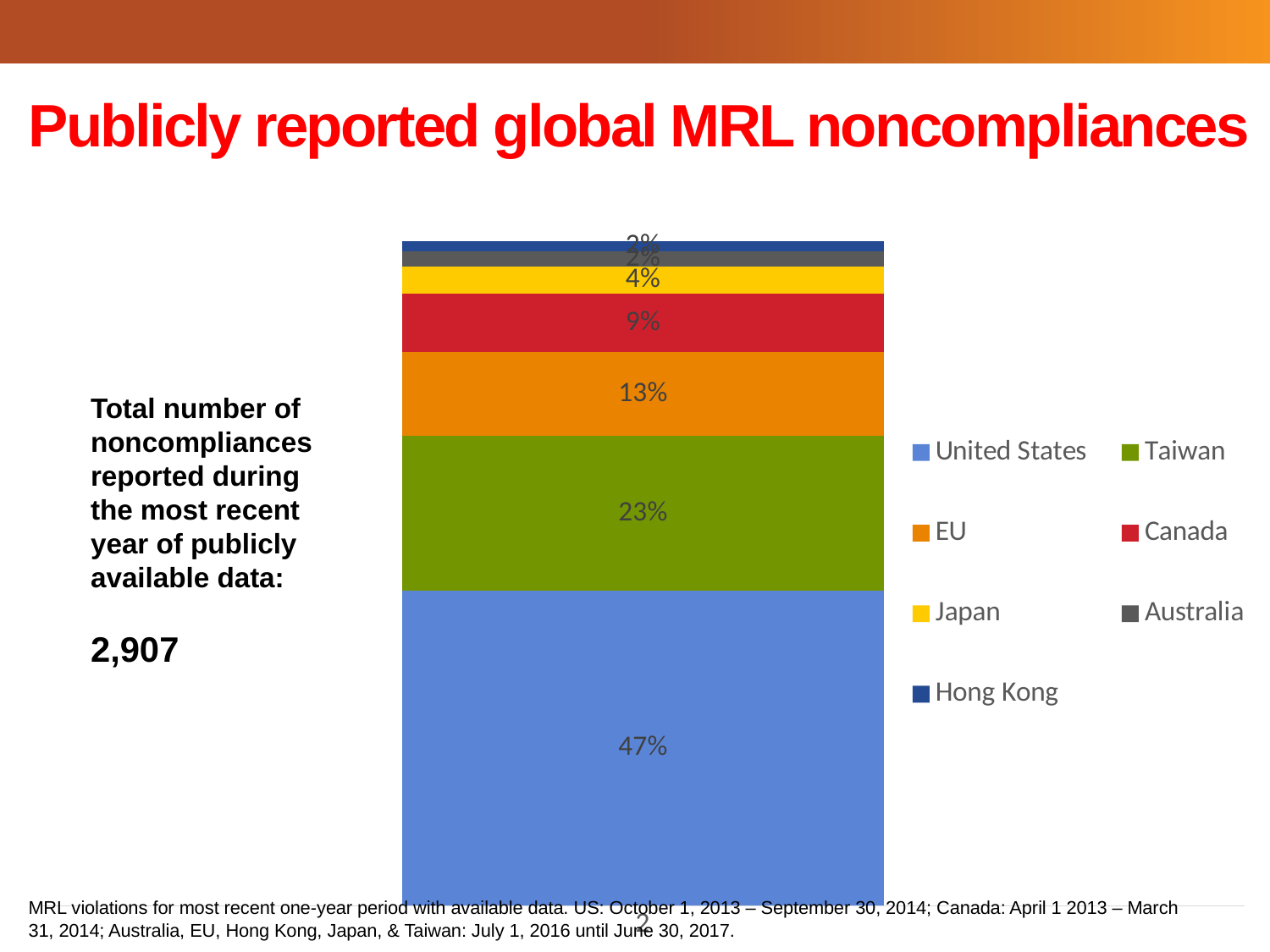
By how many percentage points does Taiwan's share exceed the EU's share? 10 percentage points What percentage is shown for Japan? 4% What colour represents Taiwan in the legend? Green What percentage is shown for Canada? 9% Which has the larger share, the EU or Canada? EU What share of noncompliances is attributed to the United States in the stacked bar? 47% How many series does the legend list? 7 What kind of chart is shown on the slide? Stacked bar chart By how many percentage points does the United States share exceed the Taiwan share? 24 percentage points What percentage does the Taiwan segment show? 23% What is the value labelled on the EU segment? 13% Which country or region accounts for the largest share of noncompliances? United States